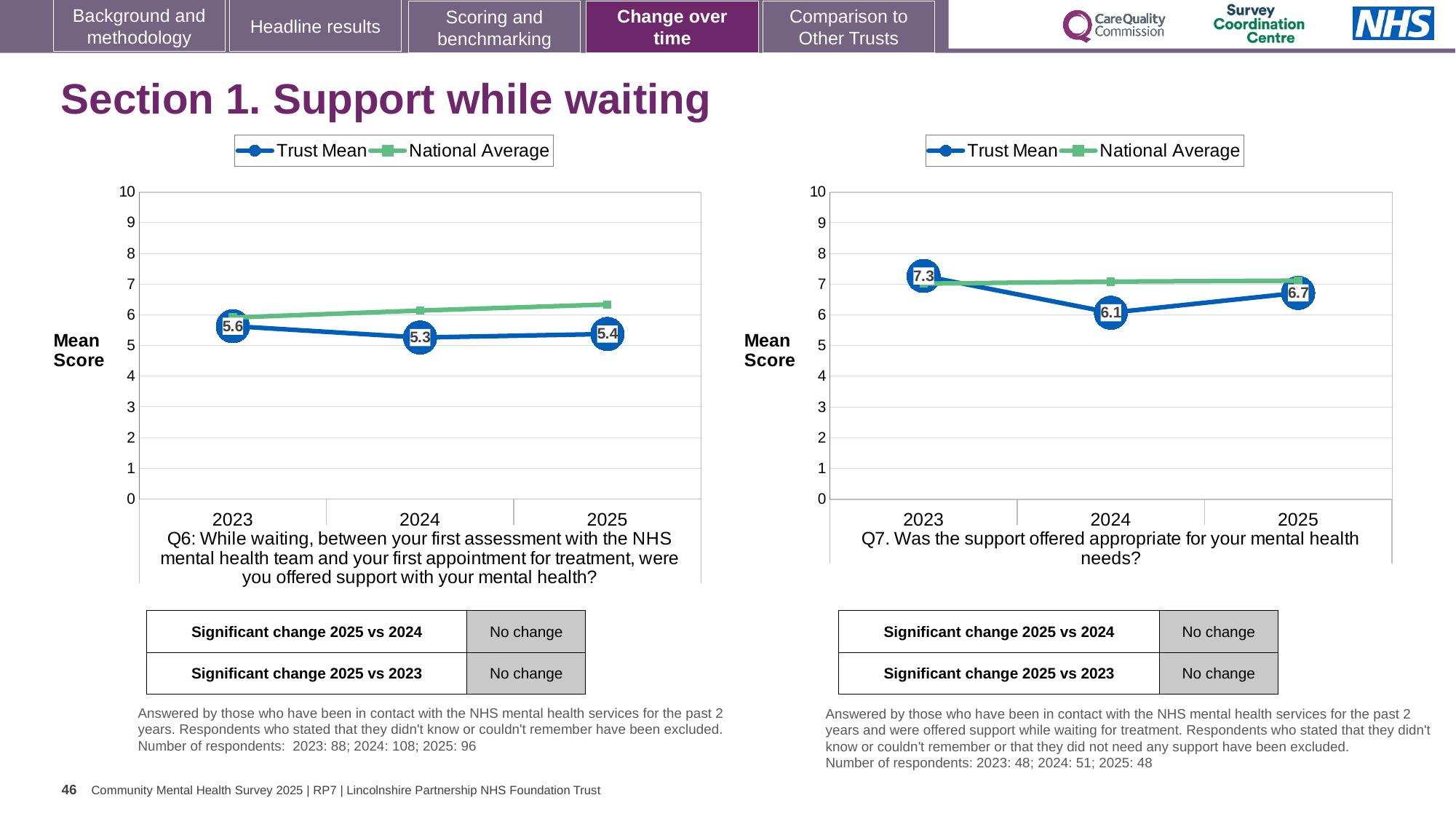
In the Q7 chart on the right, what is the difference between the Trust Mean scores for 2023 and 2024? 1.2 In the Q7 chart on the right, what is the Trust Mean score for 2024? 6.1 How many series does the legend of the Q6 chart on the left list? 2 In the Q7 chart on the right, which year has the highest Trust Mean score? 2023 In the Q6 chart on the left, what is the Trust Mean score for 2023? 5.6 In the Q6 chart on the left, which year has the lowest Trust Mean score? 2024 What type of chart is the Q7 chart on the right? Line chart In the Q6 chart on the left, is the Trust Mean score higher in 2023 or in 2025? 2023 In the Q7 chart on the right, is the National Average value for 2024 greater or less than 8? less In the Q6 chart on the left, is the National Average value for 2025 greater or less than 6? greater How many years are plotted on the x axis of the Q7 chart on the right? 3 In the Q6 chart on the left, what is the Trust Mean score for 2025? 5.4